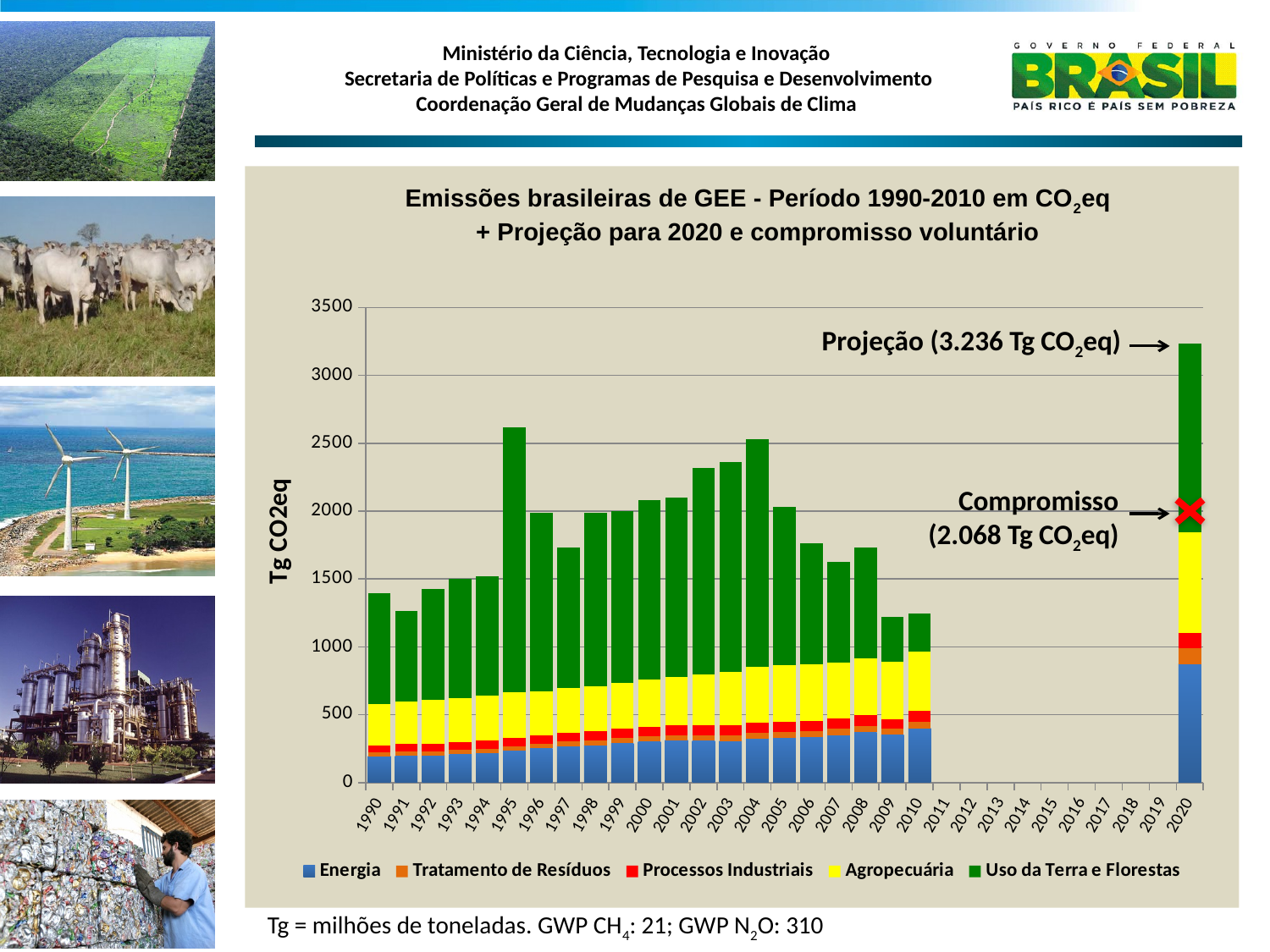
Which year has the larger total bar, 1995 or 1996? 1995 Is the total for 1990 greater or less than 1500? less What kind of chart is shown on the slide? bar chart What is the label of the y axis? Tg CO2eq What is the value of the voluntary commitment (Compromisso) shown on the chart? 2.068 Tg CO2eq What is the difference between the 2020 projection and the Compromisso value? 1.168 Tg CO2eq How many series does the legend list? 5 What is the projected emissions value for 2020 given in the annotation? 3.236 Tg CO2eq Is the total for 1995 greater or less than 2500? greater Does the Energia (blue) segment rise or fall from 1990 to 2010? rises Which year has the tallest bar on the chart? 2020 Among the years 1990 to 2010, which year has the tallest bar? 1995